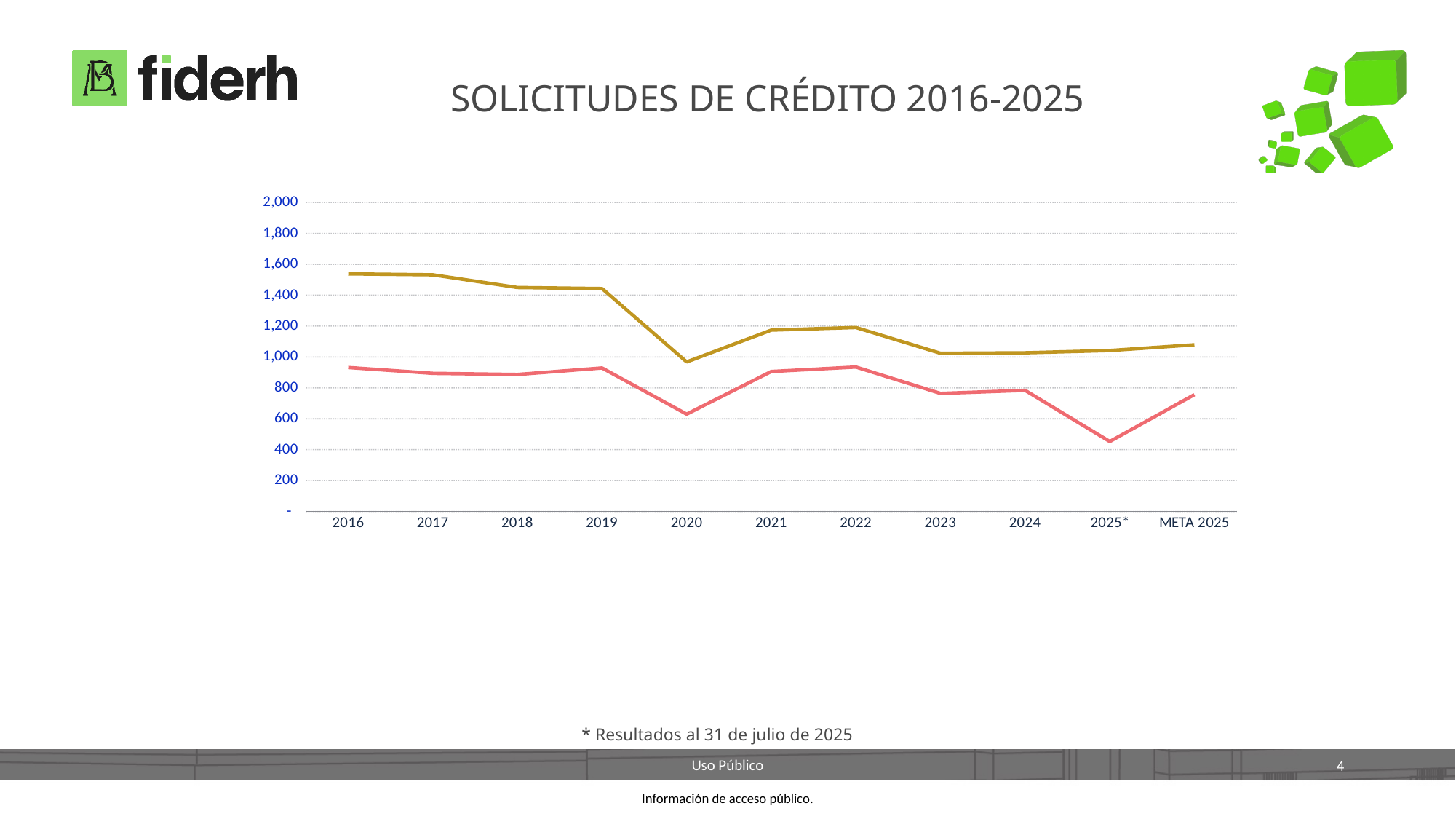
In which category does the gold line reach its lowest value? 2020 Is the value of the pink line for 2020 greater or less than 800? less Is the value of the pink line for 2025* greater or less than 600? less Does the gold line rise or fall from 2016 to 2020? Fall How many lines are plotted on the chart? 2 Is the value of the gold line for 2020 greater or less than 1,200? less In which category does the pink line reach its lowest value? 2025* What kind of chart is shown on the slide? Line chart How many categories are shown along the x axis of the chart? 11 What is the title of the chart? SOLICITUDES DE CRÉDITO 2016-2025 For 2020, which line has the larger value, the gold line or the pink line? The gold line